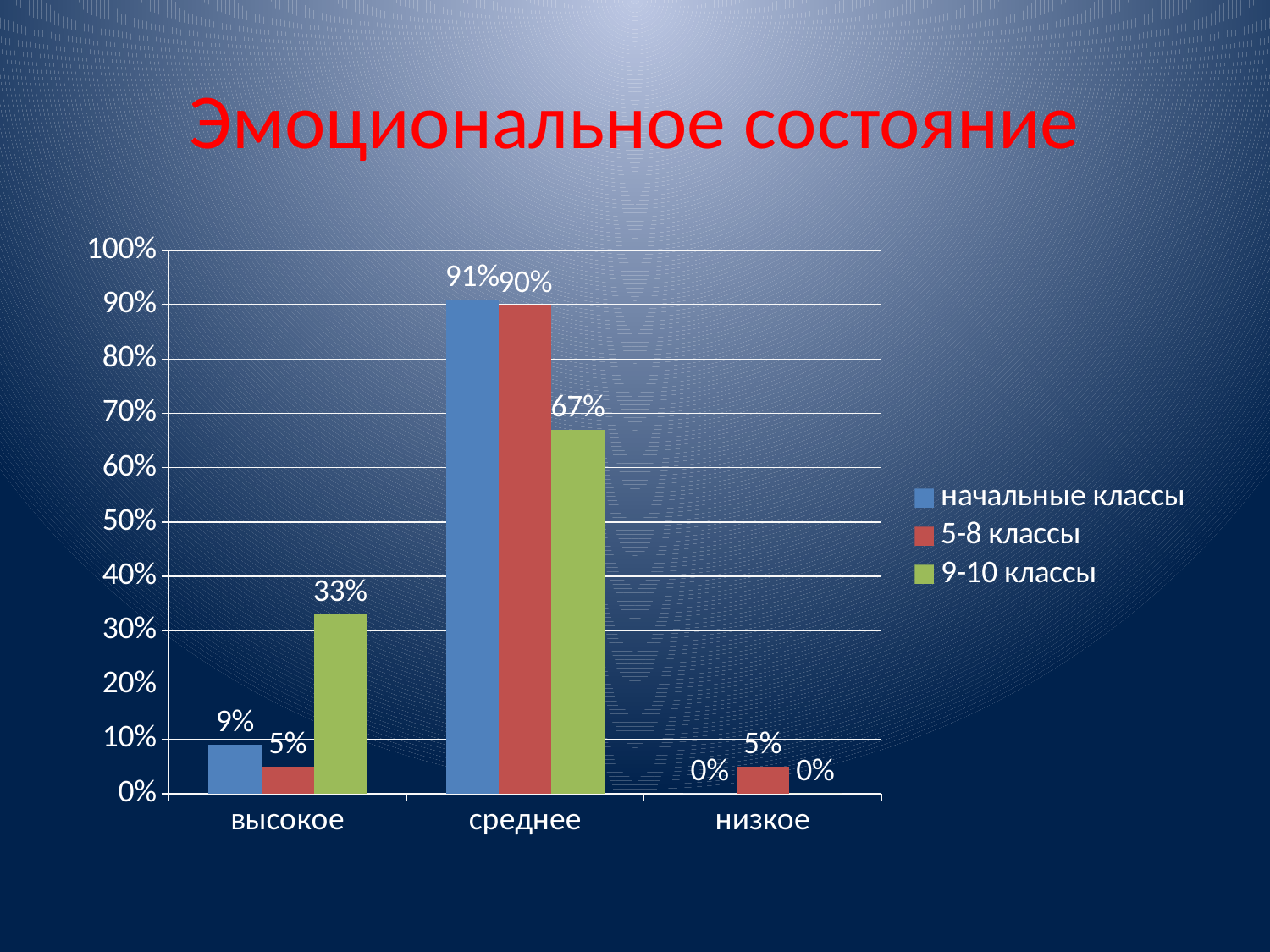
What is the difference between the начальные классы and 9-10 классы values in the среднее category? 24% What is the title of the slide? Эмоциональное состояние What is the value for 9-10 классы in the среднее category? 67% What is the value for начальные классы in the высокое category? 9% Which series has the highest value in the среднее category? начальные классы What kind of chart is shown on the slide? bar chart How many series does the legend list? 3 What is the value for 9-10 классы in the высокое category? 33% Which series has the lowest value in the высокое category? 5-8 классы What is the value for 5-8 классы in the низкое category? 5% Which is larger: the 9-10 классы value for высокое or the 5-8 классы value for высокое? 9-10 классы value for высокое How many categories are shown on the x axis? 3